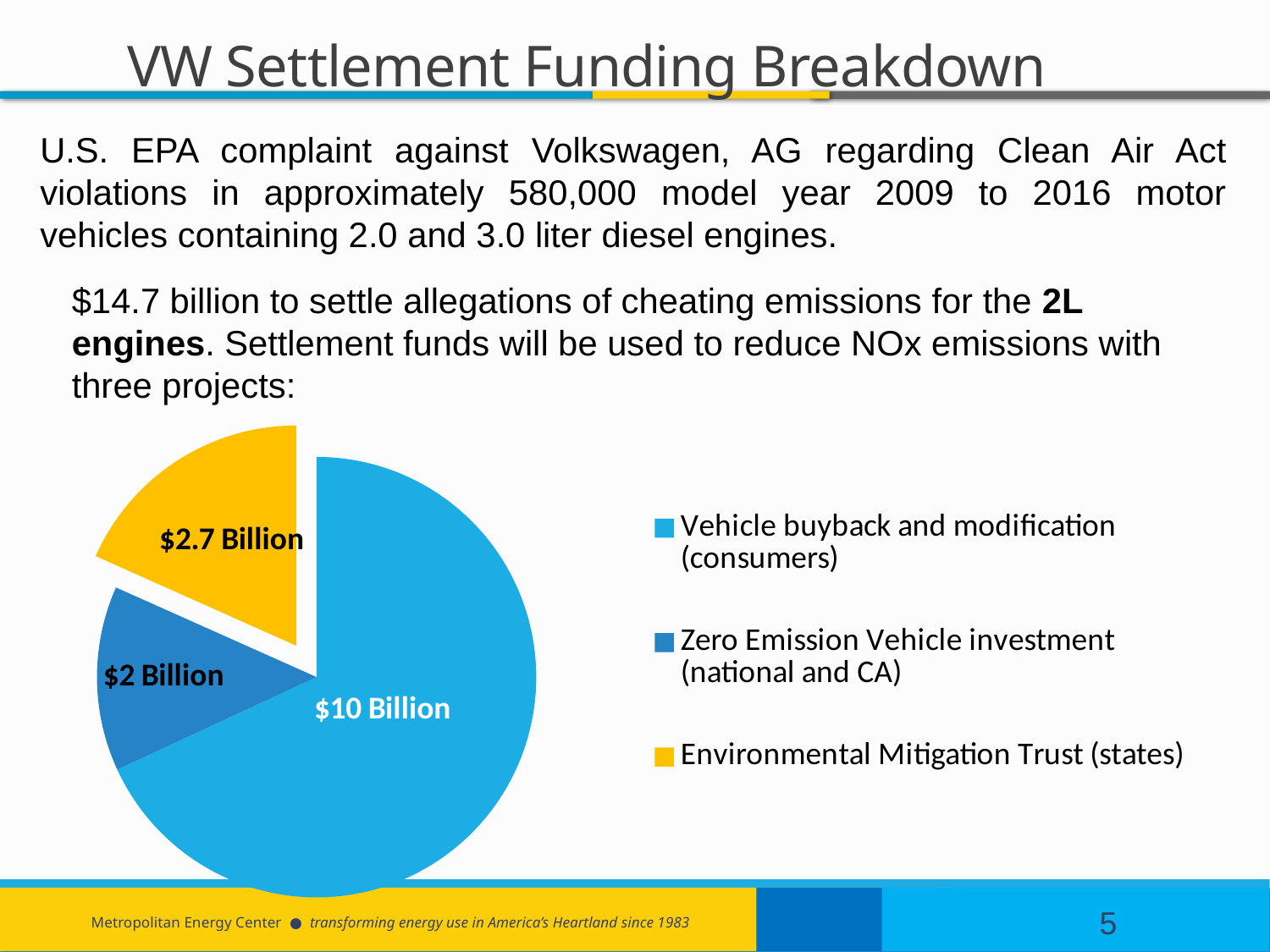
What is the value of the Zero Emission Vehicle investment (national and CA) slice? $2 Billion What colour is the Environmental Mitigation Trust (states) slice? Yellow What is the value of the Environmental Mitigation Trust (states) slice? $2.7 Billion What is the total of all three slices in the pie chart? $14.7 Billion Which category receives the smallest share of the settlement funding? Zero Emission Vehicle investment (national and CA) What type of chart is shown on the slide? Pie chart How many slices does the pie chart have? 3 What is the difference between the Environmental Mitigation Trust slice and the Zero Emission Vehicle investment slice? $0.7 Billion What is the difference between the Vehicle buyback and modification slice and the Environmental Mitigation Trust slice? $7.3 Billion What is the value of the Vehicle buyback and modification (consumers) slice? $10 Billion Which is larger: the Environmental Mitigation Trust (states) slice or the Zero Emission Vehicle investment (national and CA) slice? Environmental Mitigation Trust (states) Which category receives the largest share of the settlement funding? Vehicle buyback and modification (consumers)